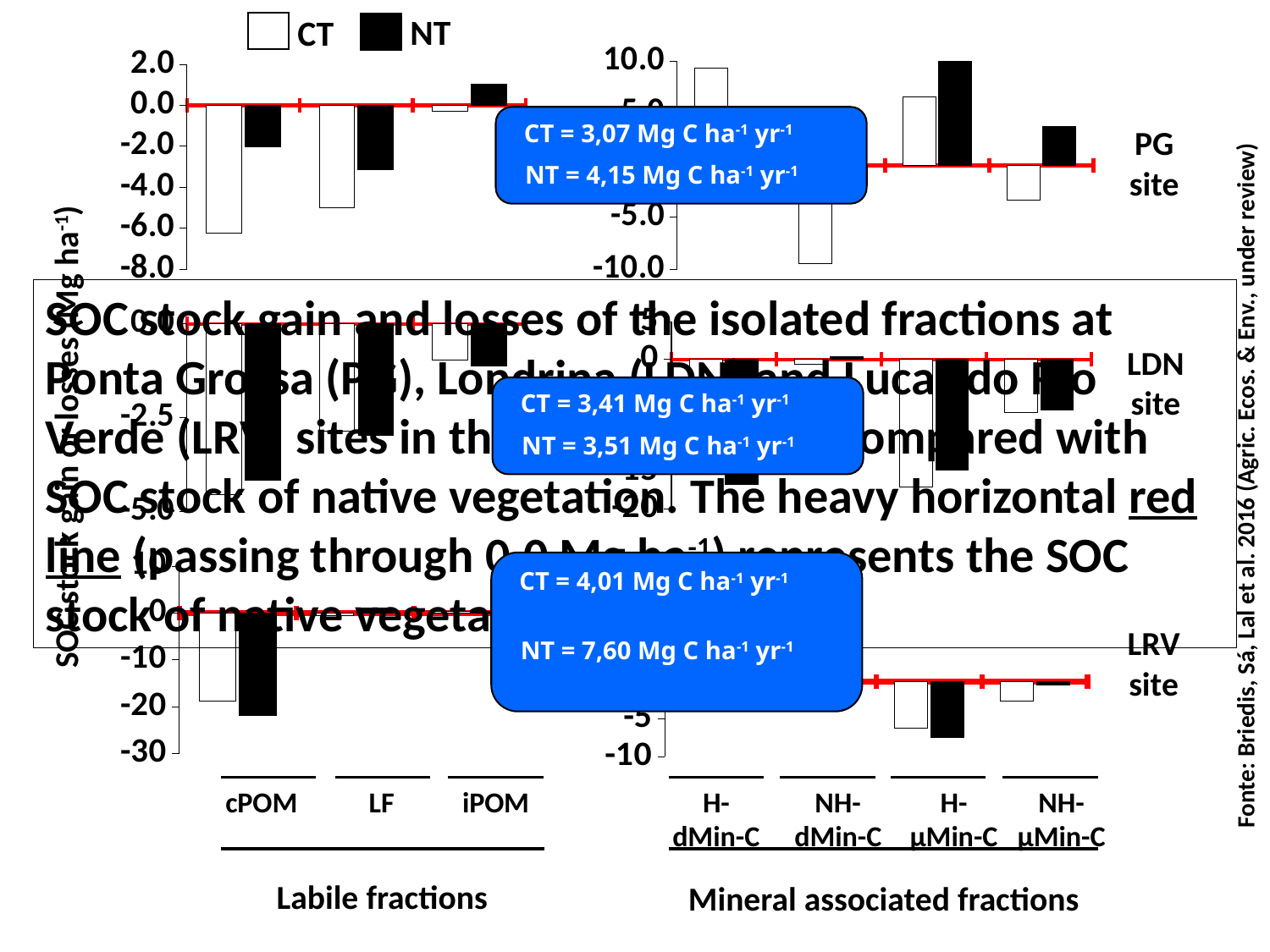
In the PG site labile fractions chart (top left), which category has the lowest CT value? cPOM In the LRV site labile fractions chart (bottom left), is the CT value for cPOM greater or less than -10? less In the legend, which series is shown with black bars? NT How many fraction categories are shown on the x axis of the mineral associated fractions charts (right column)? 4 In the PG site mineral associated fractions chart (top right), is the CT value for NH-dMin-C greater or less than -5.0? less What kind of chart is used for the PG site labile fractions panel (top left)? bar chart In the PG site labile fractions chart (top left), is the NT value for iPOM greater or less than 0.0? greater How many fraction categories are shown on the x axis of the labile fractions charts (left column)? 3 How many series does the legend list for the charts on the slide? 2 In the PG site labile fractions chart (top left), which series has the lower value for cPOM, CT or NT? CT